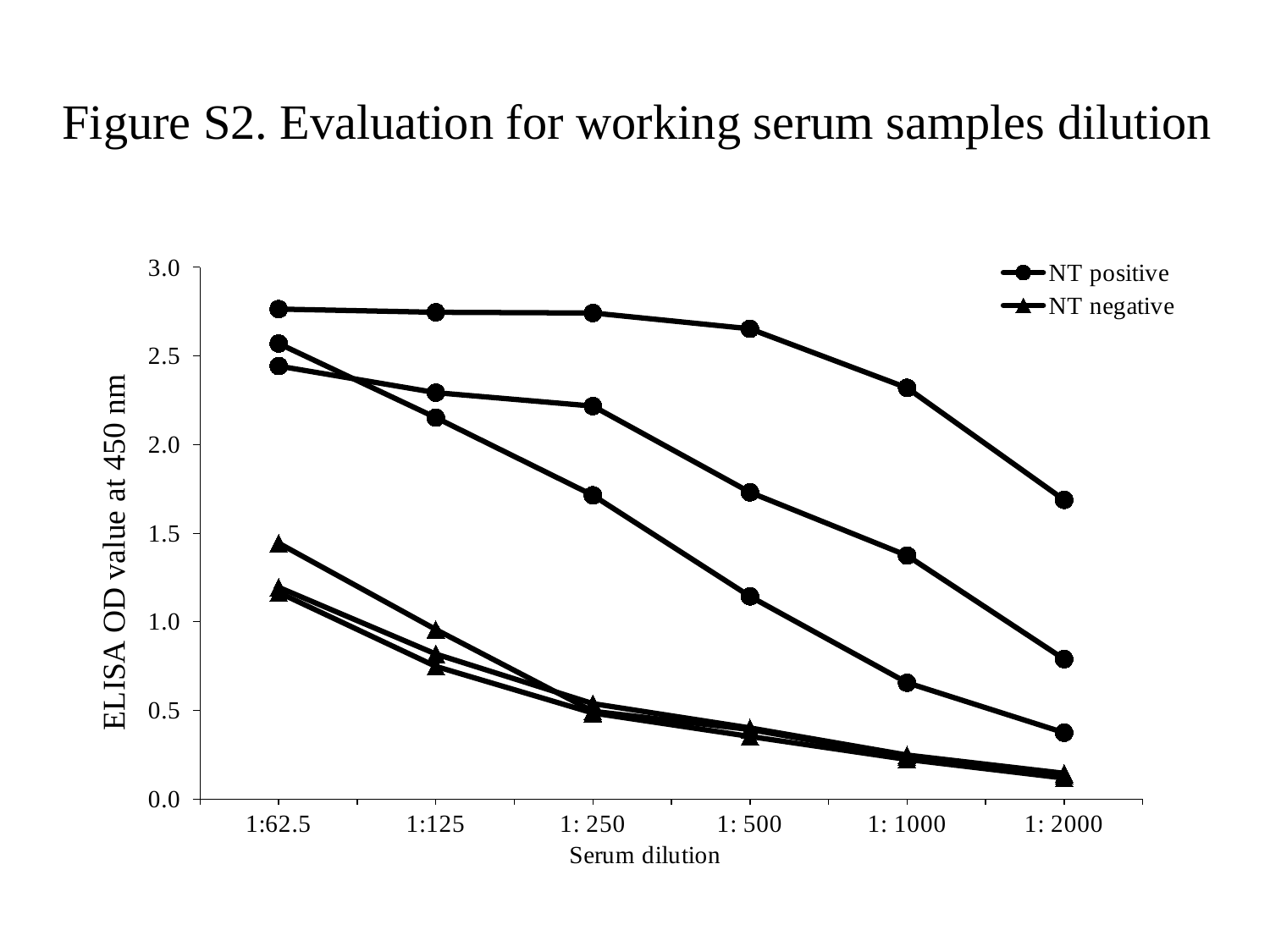
How many serum dilution points are shown on the x axis? 6 Is the lowest NT positive value at 1:2000 greater or less than 0.5? less Which marker shape is used for the NT negative series in the legend? triangle How many series does the legend list? 2 Are all the NT negative values at 1:62.5 greater or less than 2.0? less Are all the NT positive values at 1:62.5 greater or less than 2.0? greater What kind of chart is shown on the slide? line chart What is the label of the y axis? ELISA OD value at 450 nm Do the ELISA OD values rise or fall as the serum dilution increases from 1:62.5 to 1:2000? fall